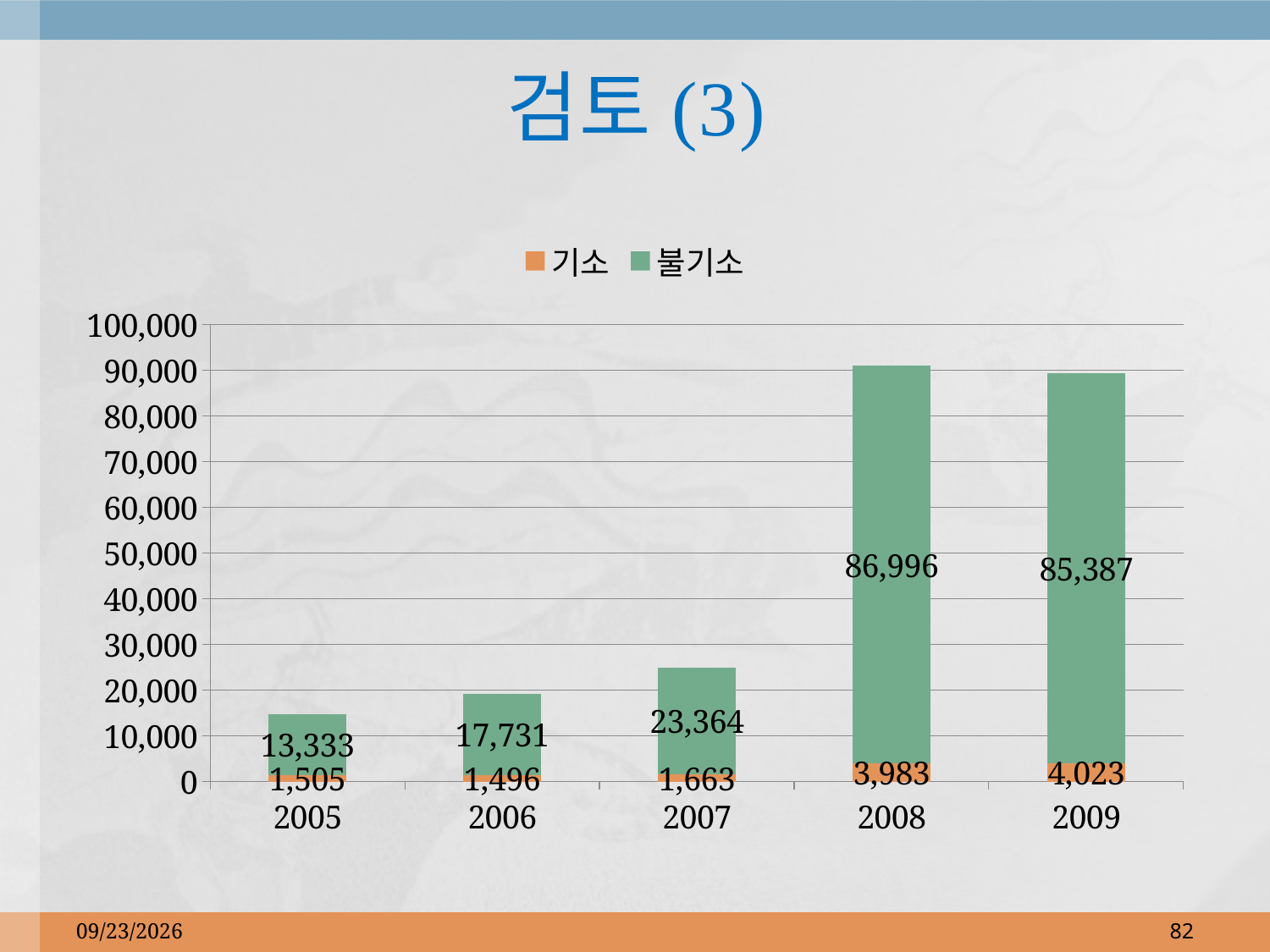
Which year has the lowest 기소 value? 2006 Which year has the highest 불기소 value? 2008 How many series does the legend list? 2 What is the value of 불기소 for 2008? 86,996 What is the value of 불기소 for 2007? 23,364 Which is larger, the 기소 value for 2009 or for 2008? 2009 How many years are shown on the x axis? 5 What kind of chart is shown on the slide? Stacked bar chart What is the difference between the 불기소 values for 2008 and 2009? 1,609 What is the total of the stacked bar for 2008? 90,979 What is the value of 기소 for 2005? 1,505 What is the total of the stacked bar for 2005? 14,838